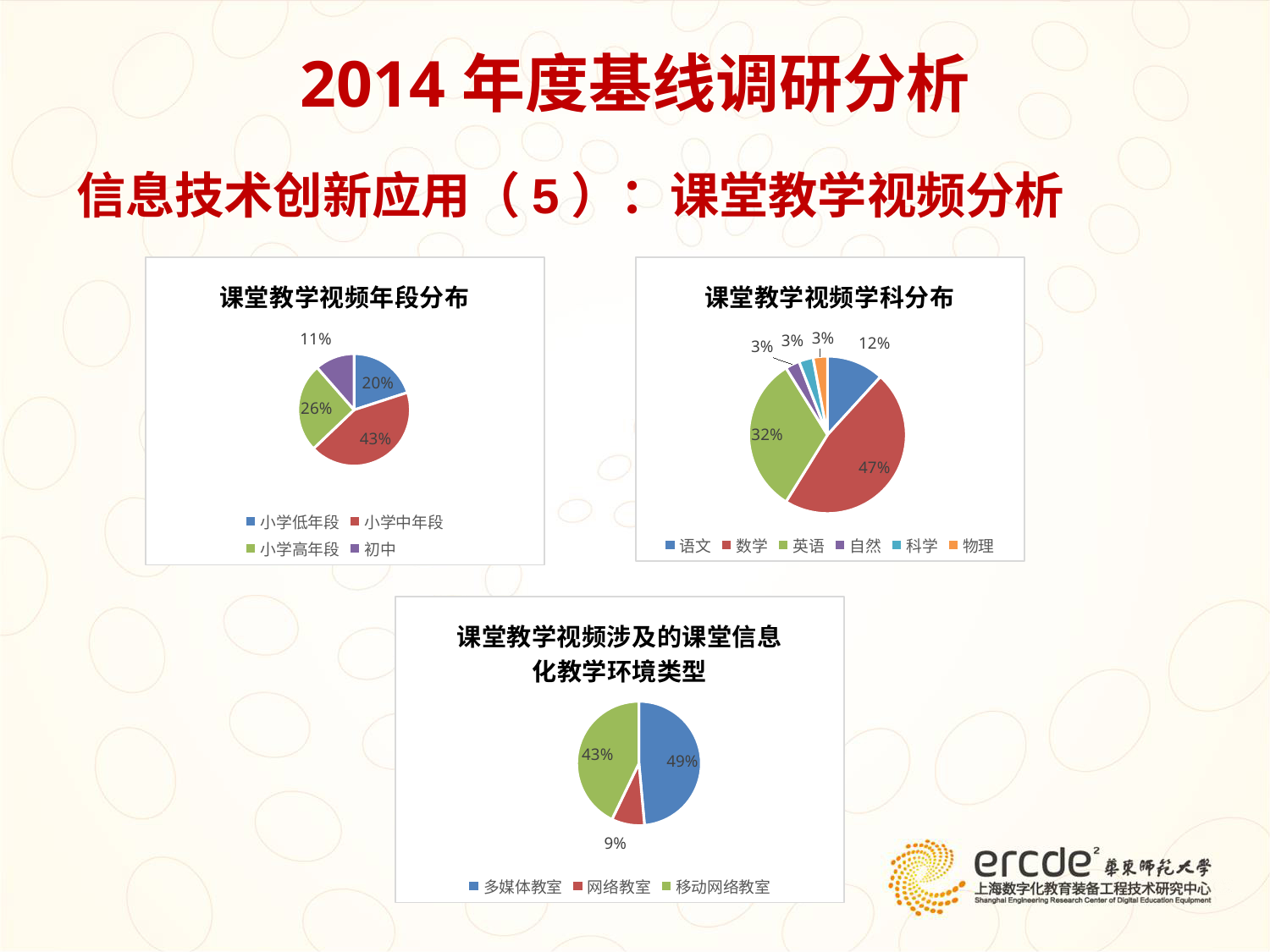
In the chart titled 课堂教学视频学科分布, which is larger, 语文 or 英语? 英语 In the chart titled 课堂教学视频学科分布, how many subjects does the legend list? 6 In the chart titled 课堂教学视频年段分布, which category has the smallest share? 初中 In the chart titled 课堂教学视频学科分布, what share of the pie is 数学? 47% In the chart titled 课堂教学视频涉及的课堂信息化教学环境类型, which category has the largest share? 多媒体教室 In the chart titled 课堂教学视频年段分布, how many categories does the legend list? 4 What kind of chart is the chart titled 课堂教学视频涉及的课堂信息化教学环境类型? pie chart In the chart titled 课堂教学视频年段分布, what colour is the slice for 小学低年段? blue In the chart titled 课堂教学视频年段分布, what is the difference in percentage points between 小学高年段 and 小学低年段? 6 In the chart titled 课堂教学视频涉及的课堂信息化教学环境类型, what share of the pie is 网络教室? 9% In the chart titled 课堂教学视频学科分布, which subject has the largest share? 数学 In the chart titled 课堂教学视频年段分布, what share of the pie is 小学中年段? 43%